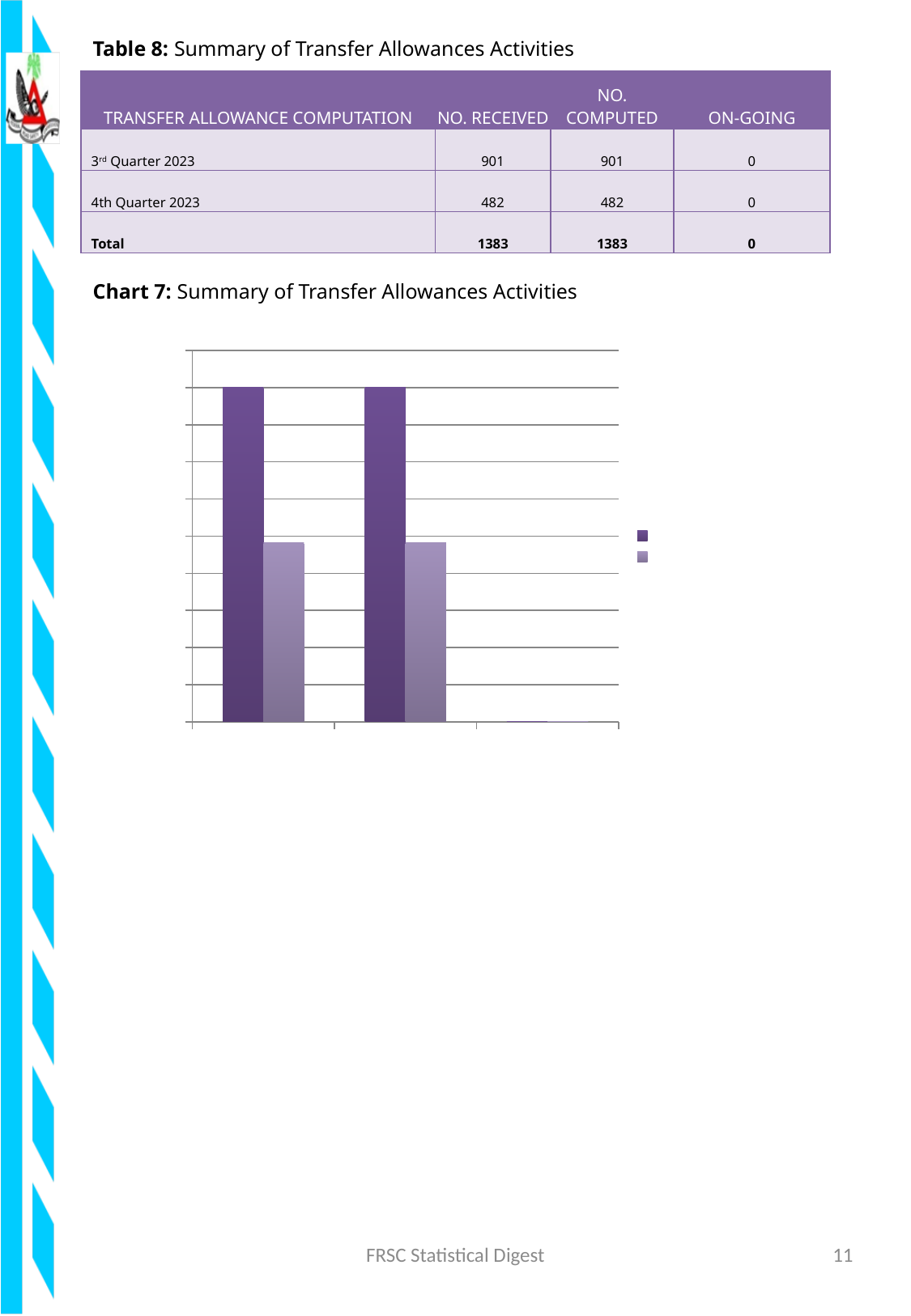
What is the title of the chart on the slide? Chart 7: Summary of Transfer Allowances Activities In the second group of bars in Chart 7, is the lighter purple bar taller or shorter than the darker purple bar? shorter How many groups of bars are plotted along the x axis of Chart 7? 3 In Chart 7, which series is drawn in the darker purple colour, the first or the second legend entry? the first How many series does the legend of Chart 7 list? 2 In the first group of bars in Chart 7, is the darker purple bar taller or shorter than the lighter purple bar? taller What kind of chart is Chart 7? bar chart